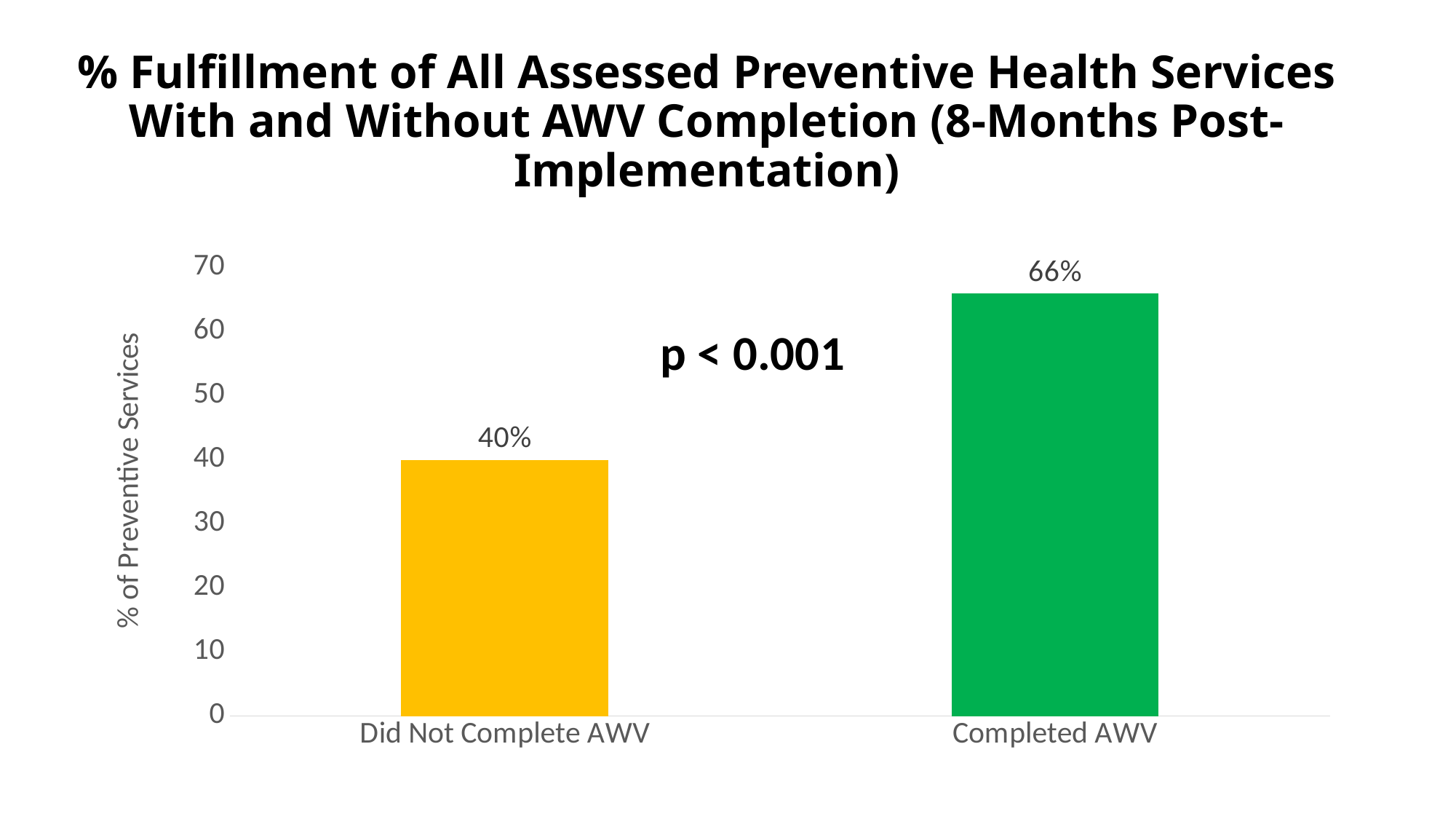
What kind of chart is shown on the slide? bar chart What is the label of the y axis? % of Preventive Services How many categories are shown on the x axis? 2 What is the value for Did Not Complete AWV? 40% Is the value for Completed AWV greater or less than 60? greater What p-value is printed on the chart? p < 0.001 Which category has the highest value? Completed AWV Is the value for Did Not Complete AWV greater or less than 50? less Which is larger, the value for Completed AWV or the value for Did Not Complete AWV? Completed AWV What is the value for Completed AWV? 66% Which category has the lowest value? Did Not Complete AWV What is the difference between the values for Completed AWV and Did Not Complete AWV? 26%